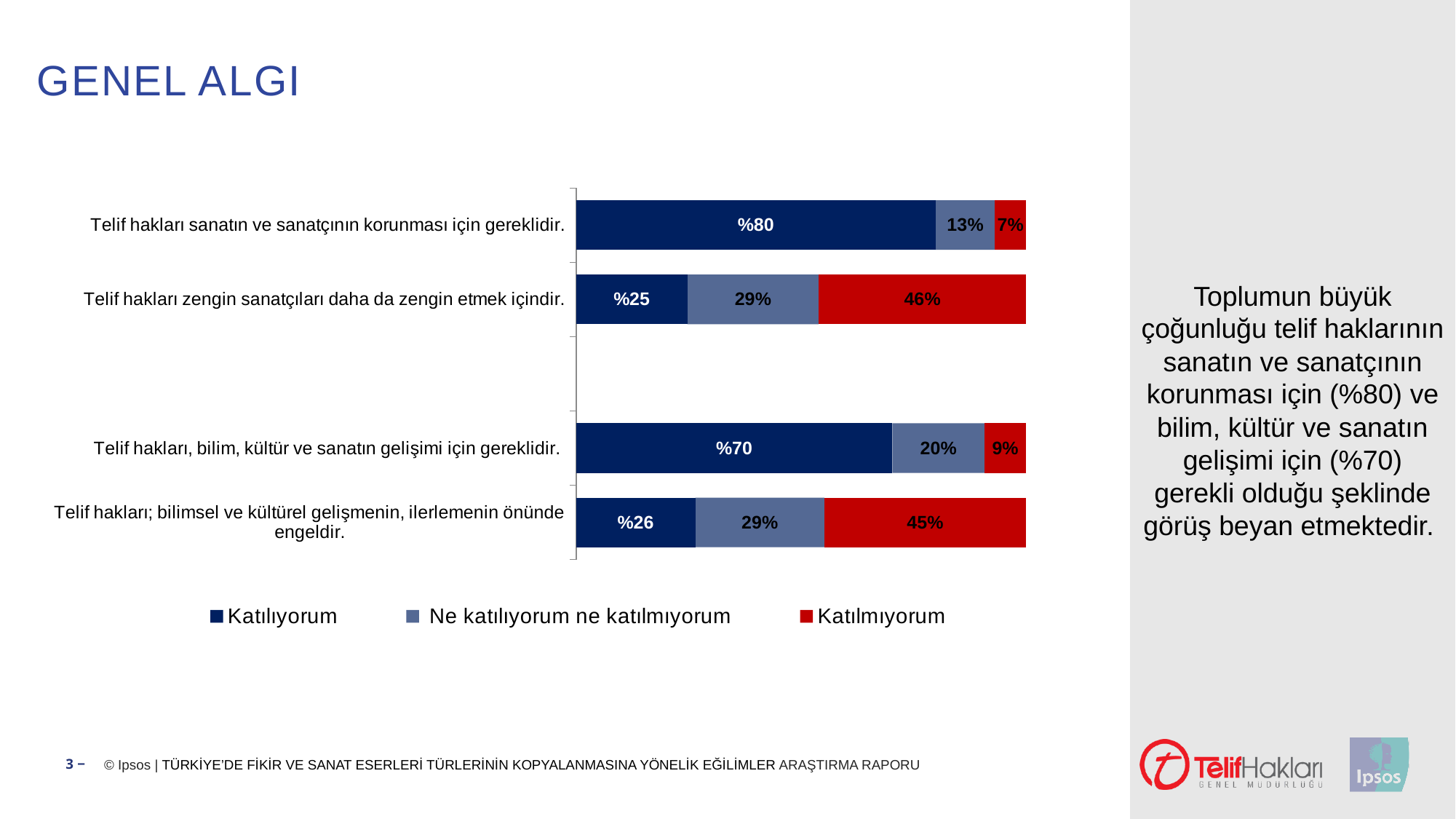
Which statement has the lowest Katılmıyorum value? Telif hakları sanatın ve sanatçının korunması için gereklidir. Which is larger: the Katılmıyorum value for "Telif hakları zengin sanatçıları daha da zengin etmek içindir." or for "Telif hakları; bilimsel ve kültürel gelişmenin, ilerlemenin önünde engeldir."? Telif hakları zengin sanatçıları daha da zengin etmek içindir. What is the Katılmıyorum value for "Telif hakları zengin sanatçıları daha da zengin etmek içindir."? 46% How many series does the legend list? 3 Which series is shown in red in the chart? Katılmıyorum What is the Katılıyorum value for "Telif hakları sanatın ve sanatçının korunması için gereklidir."? %80 What is the Ne katılıyorum ne katılmıyorum value for "Telif hakları, bilim, kültür ve sanatın gelişimi için gereklidir."? 20% What is the Katılıyorum value for "Telif hakları; bilimsel ve kültürel gelişmenin, ilerlemenin önünde engeldir."? %26 How many statements (categories) are plotted in the chart? 4 What kind of chart is shown on the slide? bar chart What is the difference between the Katılıyorum values for "Telif hakları sanatın ve sanatçının korunması için gereklidir." and "Telif hakları, bilim, kültür ve sanatın gelişimi için gereklidir."? %10 Which statement has the highest Katılıyorum value? Telif hakları sanatın ve sanatçının korunması için gereklidir.